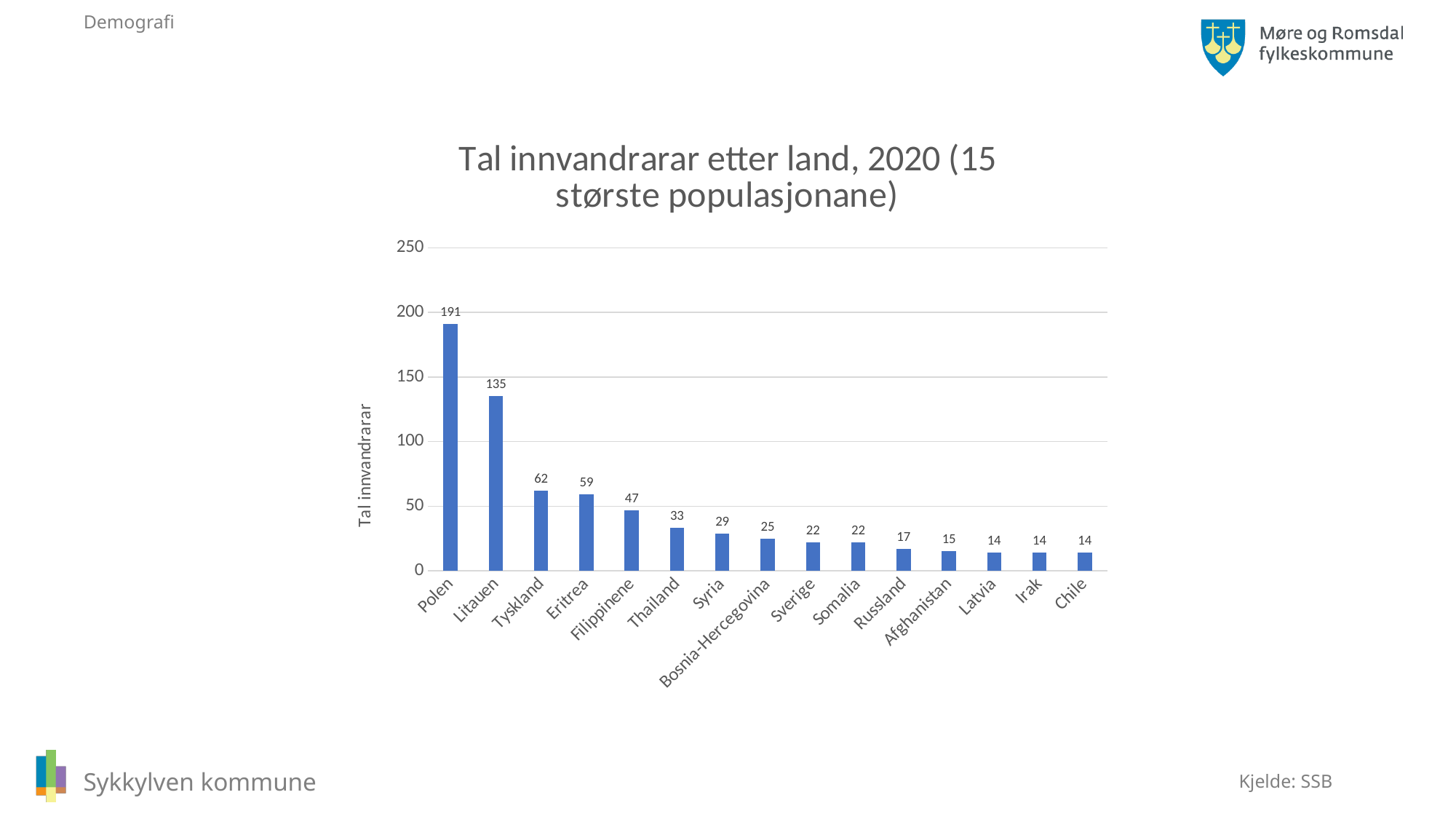
Which country has the highest value? Polen How many countries are shown on the x axis? 15 What is the difference between the values for Tyskland and Eritrea? 3 What is the value for Bosnia-Hercegovina? 25 What is the difference between the values for Polen and Litauen? 56 Do the values rise or fall from left to right along the x axis? fall What is the label of the y axis? Tal innvandrarar What is the value for Filippinene? 47 Is the value for Litauen greater or less than 100? greater What is the value for Polen? 191 What kind of chart is this? bar chart Which is larger, the value for Thailand or the value for Syria? Thailand